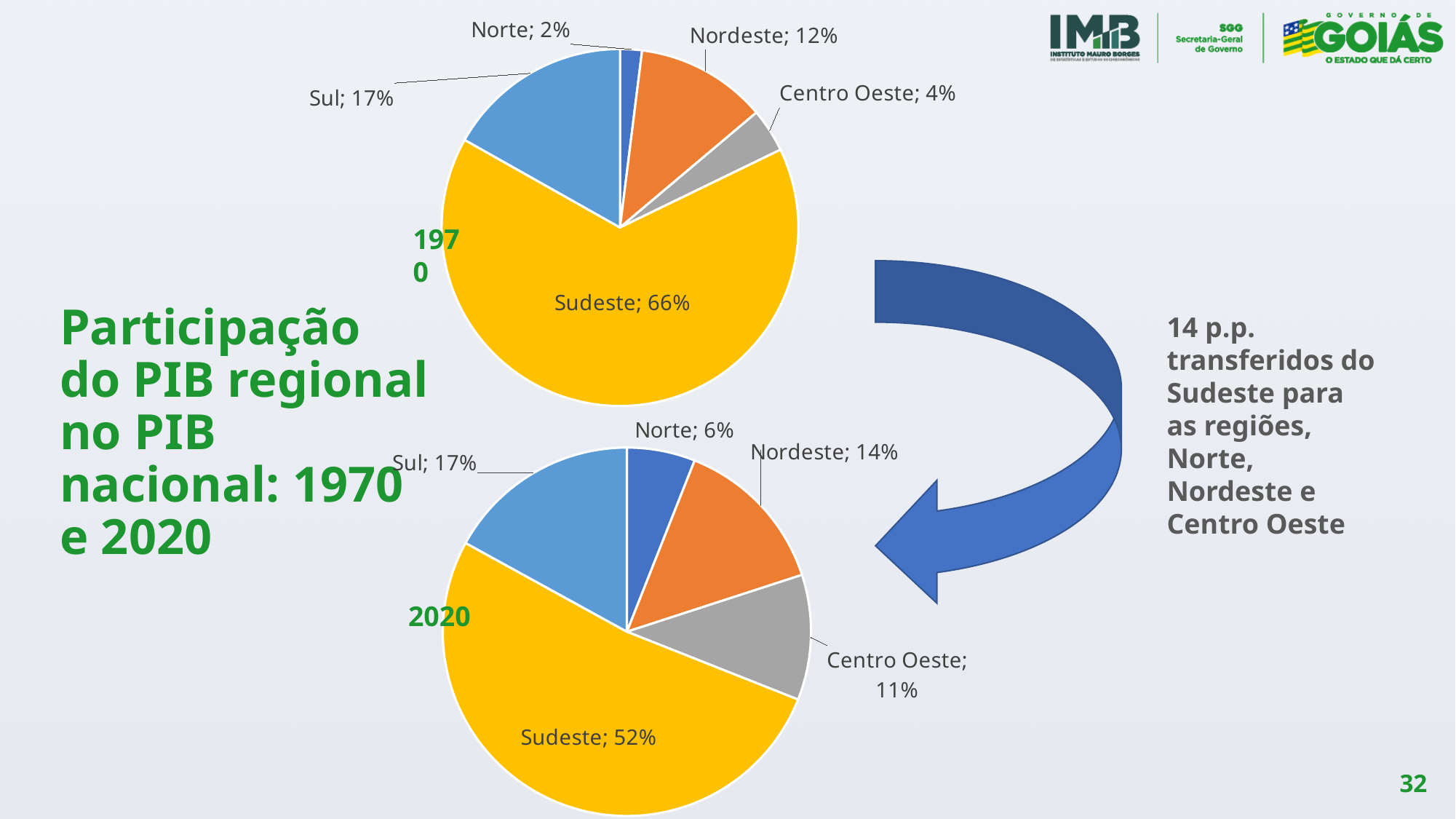
What kind of chart is the 2020 chart? Pie chart In the 2020 pie chart, which is larger: the share of Nordeste or the share of Centro Oeste? Nordeste In the 1970 pie chart, what is the difference between the shares of Sul and Centro Oeste? 13 percentage points In the 1970 pie chart, which region has the smallest share? Norte In the 2020 pie chart, what colour is the Sudeste slice? Yellow In the 2020 pie chart, which region has the largest share? Sudeste How many slices does the 1970 pie chart have? 5 In the 2020 pie chart, what share does Norte have? 6% In the 1970 pie chart, what share does Sudeste have? 66% In the 1970 pie chart, what share does Nordeste have? 12% What is the difference between Sudeste's share in the 1970 pie chart and in the 2020 pie chart? 14 percentage points In the 2020 pie chart, what share does Centro Oeste have? 11%